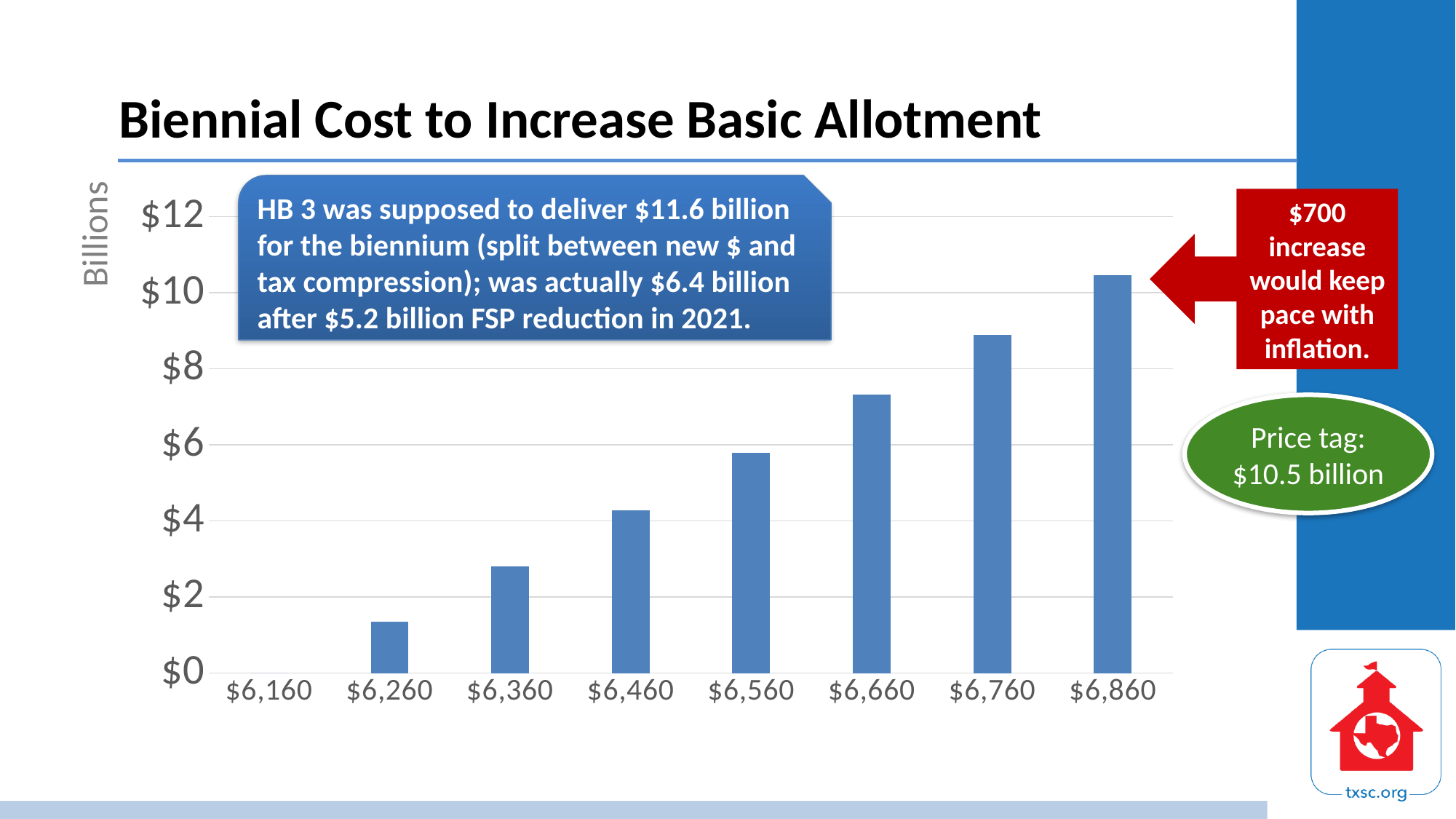
Is the value for $6,660 greater or less than $6? greater Is the value for $6,460 greater or less than $6? less Do the values rise or fall as you move from left to right along the x axis? rise What is the title of the chart? Biennial Cost to Increase Basic Allotment Which category has the lowest value? $6,160 Is the value for $6,860 greater or less than $10? greater Which category has the highest bar? $6,860 What kind of chart is shown on the slide? bar chart What is the label on the vertical axis? Billions Which is larger, the value for $6,560 or the value for $6,760? $6,760 How many categories are shown on the x axis? 8